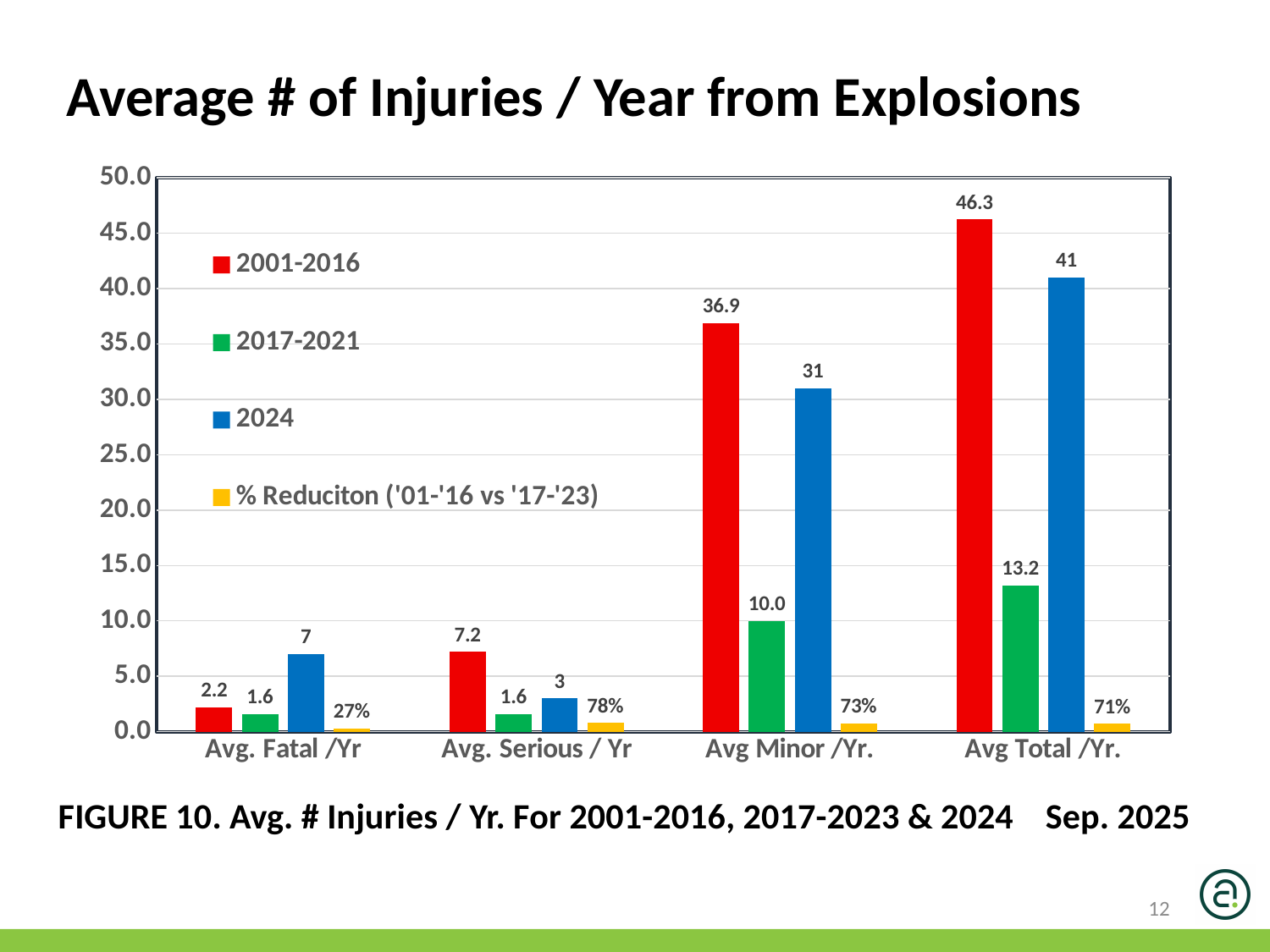
What type of chart is shown on the slide? Bar chart Which is larger in the Avg. Fatal /Yr category: the 2001-2016 value or the 2024 value? 2024 Which category has the highest value for the 2001-2016 series? Avg Total /Yr. What is the value for 2024 in the Avg Minor /Yr. category? 31 How many categories are shown on the x axis? 4 What is the difference between the 2001-2016 and 2024 values in the Avg Minor /Yr. category? 5.9 What is the value for 2017-2021 in the Avg. Serious / Yr category? 1.6 Which category has the lowest value for the 2024 series? Avg. Serious / Yr Is the 2017-2021 value for Avg Total /Yr. greater or less than 15.0? less How many series does the legend list? 4 What is the value for 2001-2016 in the Avg Total /Yr. category? 46.3 What is the % Reduction value shown for Avg. Fatal /Yr? 27%